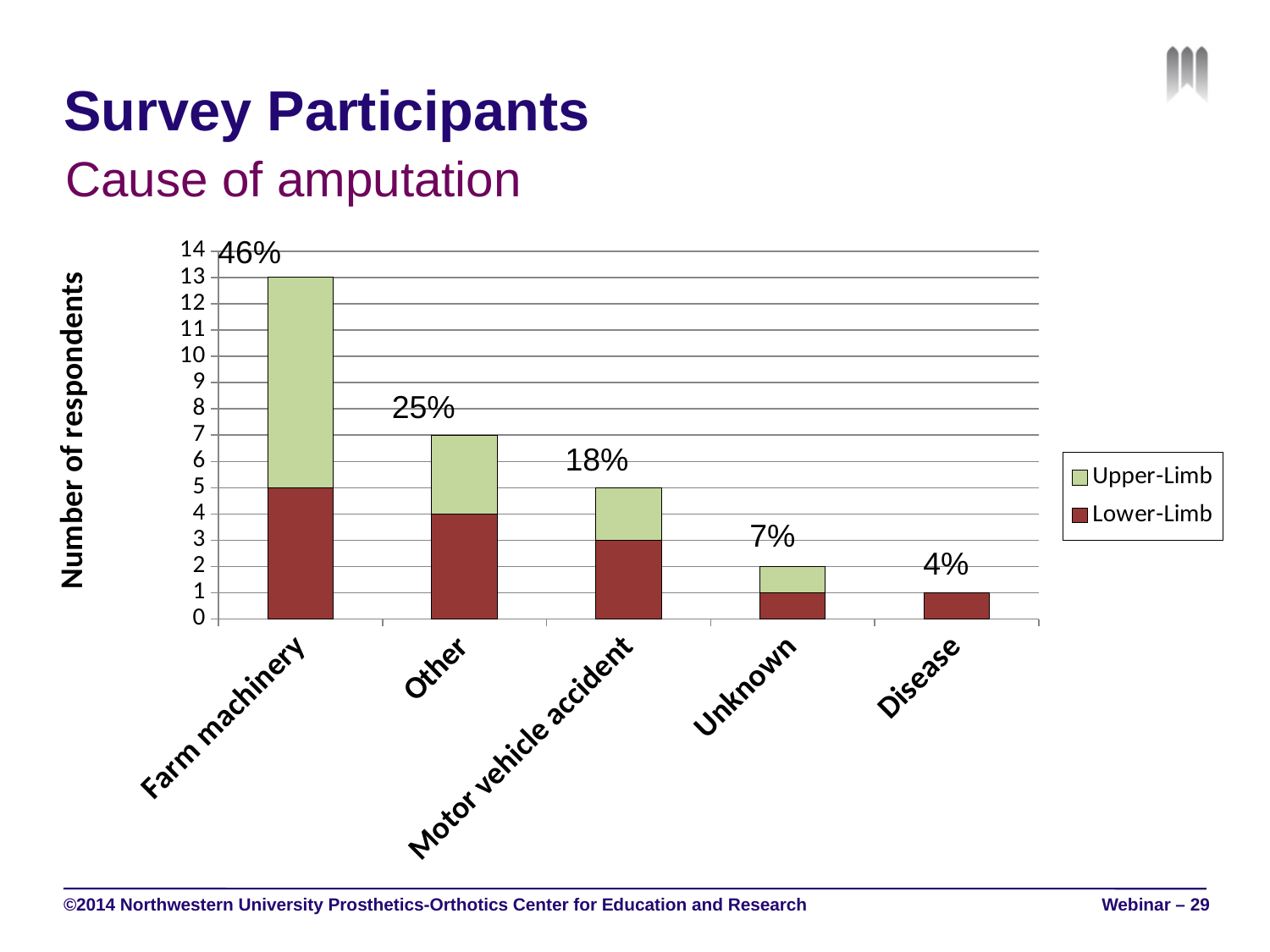
Which has more respondents, Other or Unknown? Other What percentage label is shown above the Disease bar? 4% How many series does the legend list? 2 What is the difference between the percentage labels for Other and Unknown? 18% How many Lower-Limb respondents are in the Farm machinery category? 5 What percentage label is shown above the Farm machinery bar? 46% Which cause of amputation has the lowest number of respondents? Disease Which cause of amputation has the highest number of respondents? Farm machinery How many categories are shown on the x axis? 5 What kind of chart is shown on the slide? stacked bar chart What percentage label is shown above the Motor vehicle accident bar? 18% What is the total number of respondents for the Farm machinery bar? 13